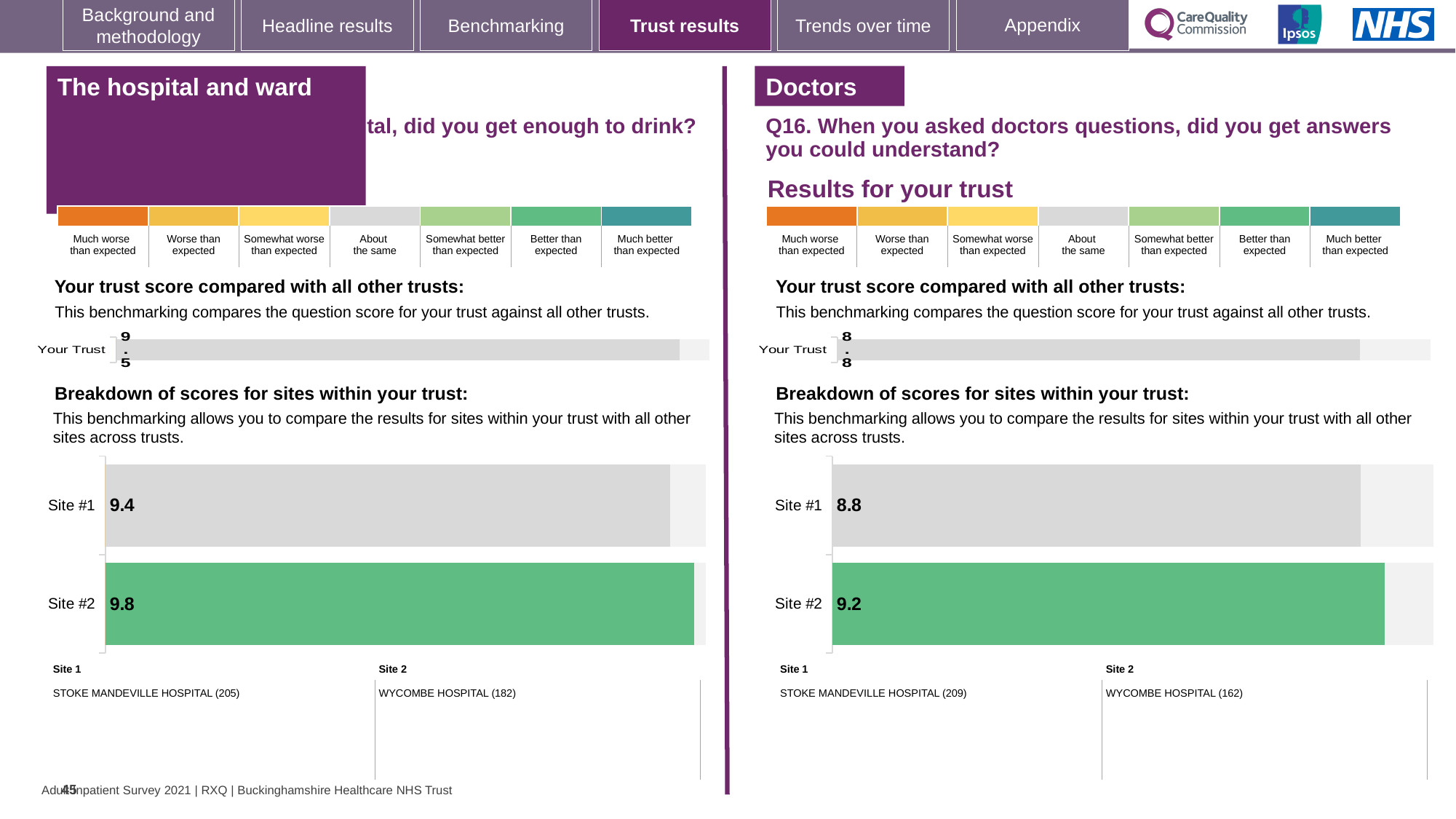
On the right-hand (Q16, Doctors) site breakdown chart, what is the score for Site #1? 8.8 On the left-hand site breakdown chart (hospital and ward section), what is the difference between the Site #2 and Site #1 scores? 0.4 What type of chart is used for the site breakdown on the right-hand (Q16, Doctors) side of the slide? Bar chart How many sites are shown on the right-hand (Q16, Doctors) site breakdown chart? 2 On the left-hand site breakdown chart (hospital and ward section), what is the score for Site #2? 9.8 On the left-hand 'Your trust score compared with all other trusts' chart (hospital and ward section), what is the score shown for Your Trust? 9.5 On the right-hand (Q16, Doctors) site breakdown chart, what is the score for Site #2? 9.2 On the right-hand (Q16, Doctors) site breakdown chart, what is the difference between the Site #2 and Site #1 scores? 0.4 On the left-hand site breakdown chart (hospital and ward section), which site has the lower score? Site #1 On the right-hand (Q16, Doctors) 'Your trust score compared with all other trusts' chart, what is the score shown for Your Trust? 8.8 On the left-hand site breakdown chart (hospital and ward section), what is the score for Site #1? 9.4 On the right-hand (Q16, Doctors) site breakdown chart, which site has the higher score? Site #2